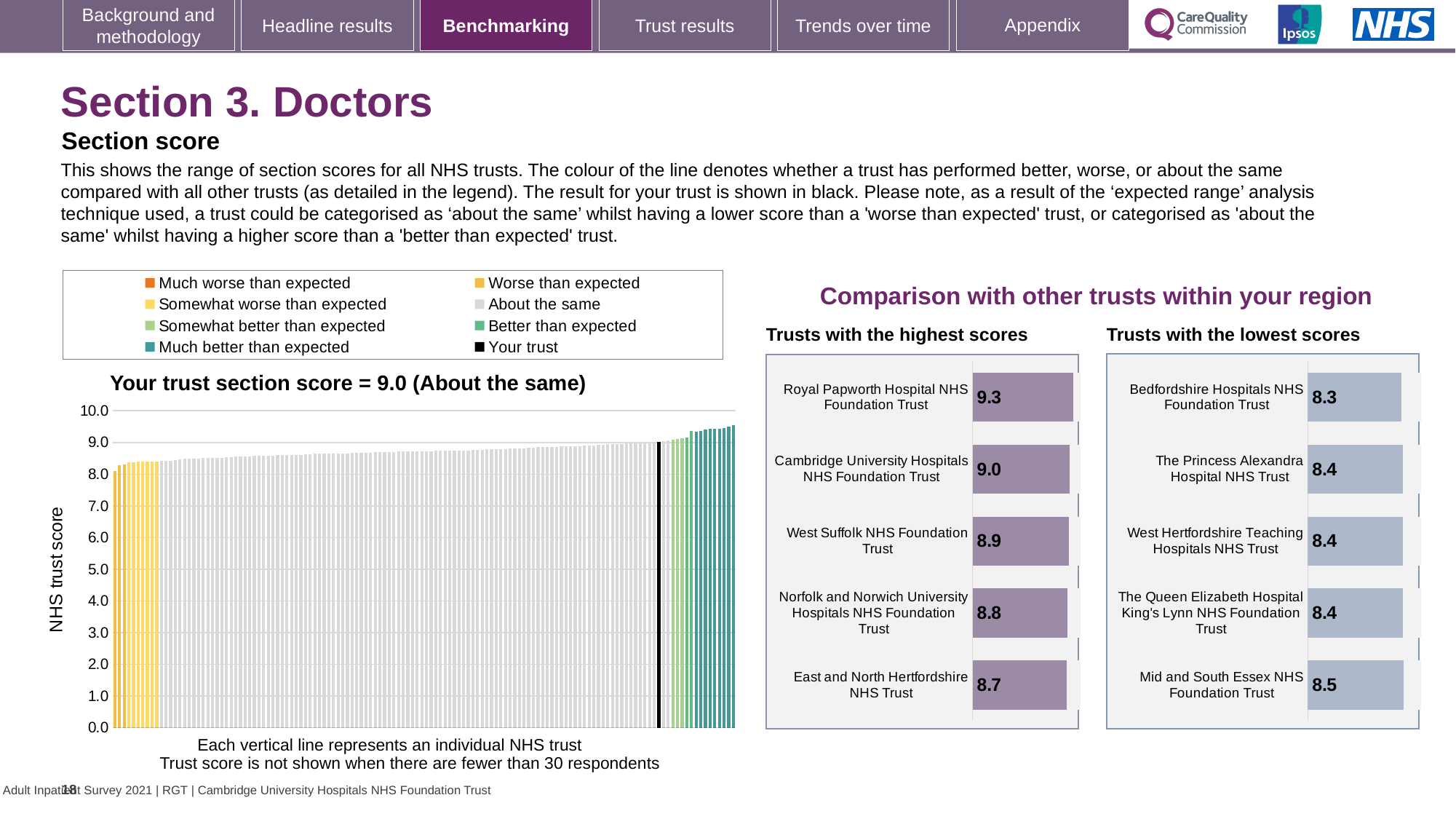
In the 'Trusts with the highest scores' chart, what is the score for Royal Papworth Hospital NHS Foundation Trust? 9.3 In the 'Trusts with the highest scores' chart, which trust has the highest score? Royal Papworth Hospital NHS Foundation Trust In the 'Your trust section score' chart on the left, what is the section score for your trust? 9.0 In the 'Trusts with the lowest scores' chart, what is the difference between the scores of Mid and South Essex NHS Foundation Trust and Bedfordshire Hospitals NHS Foundation Trust? 0.2 How many entries does the legend above the 'Your trust section score' chart list? 8 In the 'Trusts with the lowest scores' chart, which has the larger score: Mid and South Essex NHS Foundation Trust or Bedfordshire Hospitals NHS Foundation Trust? Mid and South Essex NHS Foundation Trust In the 'Trusts with the highest scores' chart, what is the score for East and North Hertfordshire NHS Trust? 8.7 In the 'Trusts with the highest scores' chart, how many trusts are listed? 5 In the 'Trusts with the lowest scores' chart, which trust has the lowest score? Bedfordshire Hospitals NHS Foundation Trust In the 'Your trust section score' chart on the left, do the trust scores rise or fall from left to right along the x axis? rise In the 'Trusts with the highest scores' chart, what is the difference between the scores of Royal Papworth Hospital NHS Foundation Trust and East and North Hertfordshire NHS Trust? 0.6 In the 'Trusts with the lowest scores' chart, what is the score for Bedfordshire Hospitals NHS Foundation Trust? 8.3